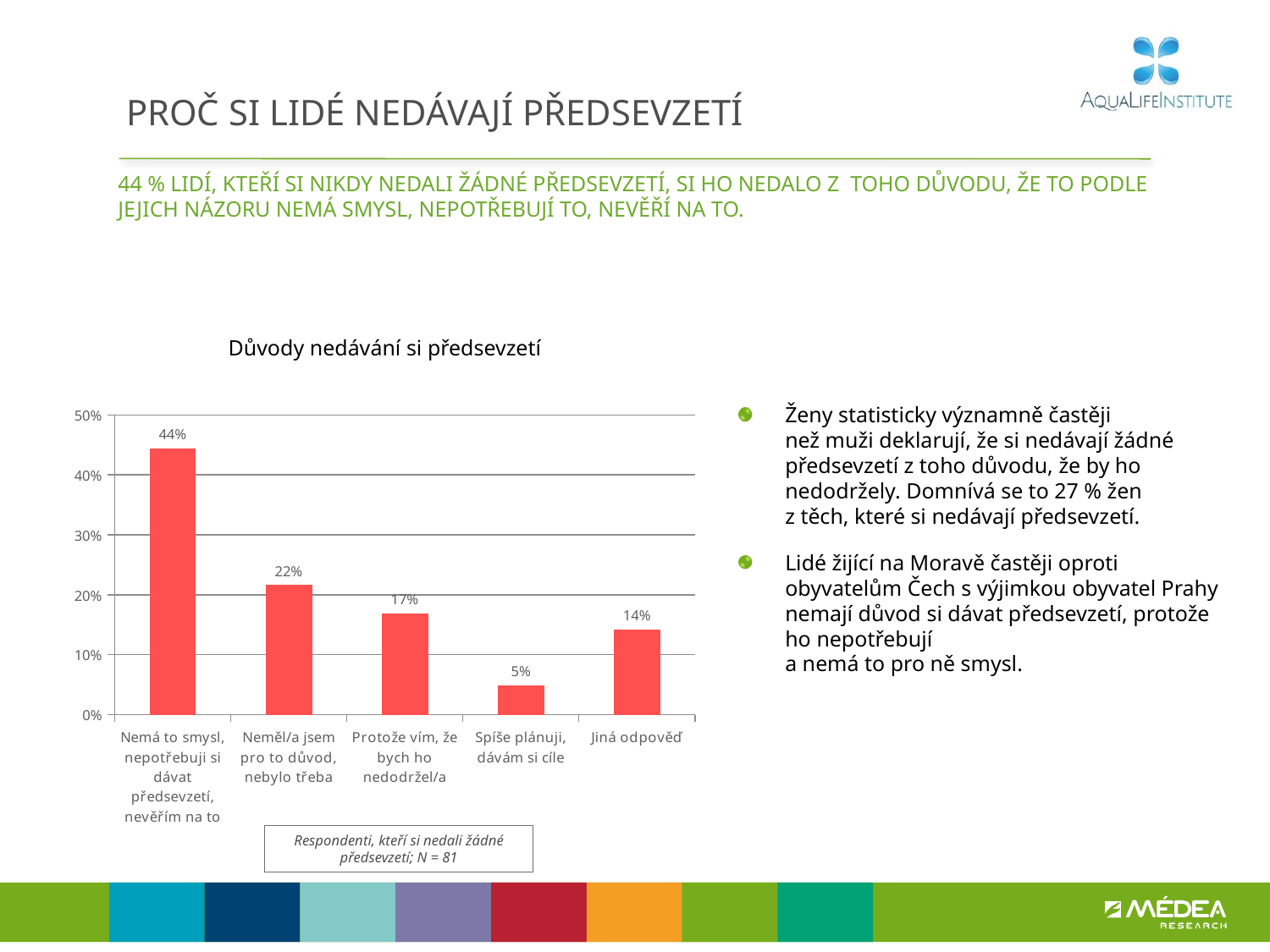
Which category has the highest value? Nemá to smysl, nepotřebuji si dávat předsevzetí, nevěřím na to What is the value for "Jiná odpověď"? 14% Is the value for "Neměl/a jsem pro to důvod, nebylo třeba" greater or less than 20%? greater Which is larger, the value for "Protože vím, že bych ho nedodržel/a" or the value for "Jiná odpověď"? Protože vím, že bych ho nedodržel/a What is the value for "Spíše plánuji, dávám si cíle"? 5% What kind of chart is shown on the slide? bar chart How many categories are shown in the chart? 5 What is the value for "Neměl/a jsem pro to důvod, nebylo třeba"? 22% What is the difference between the values for "Protože vím, že bych ho nedodržel/a" and "Spíše plánuji, dávám si cíle"? 12% What is the title of the chart? Důvody nedávání si předsevzetí Which category has the lowest value? Spíše plánuji, dávám si cíle What is the difference between the values for "Nemá to smysl, nepotřebuji si dávat předsevzetí, nevěřím na to" and "Neměl/a jsem pro to důvod, nebylo třeba"? 22%